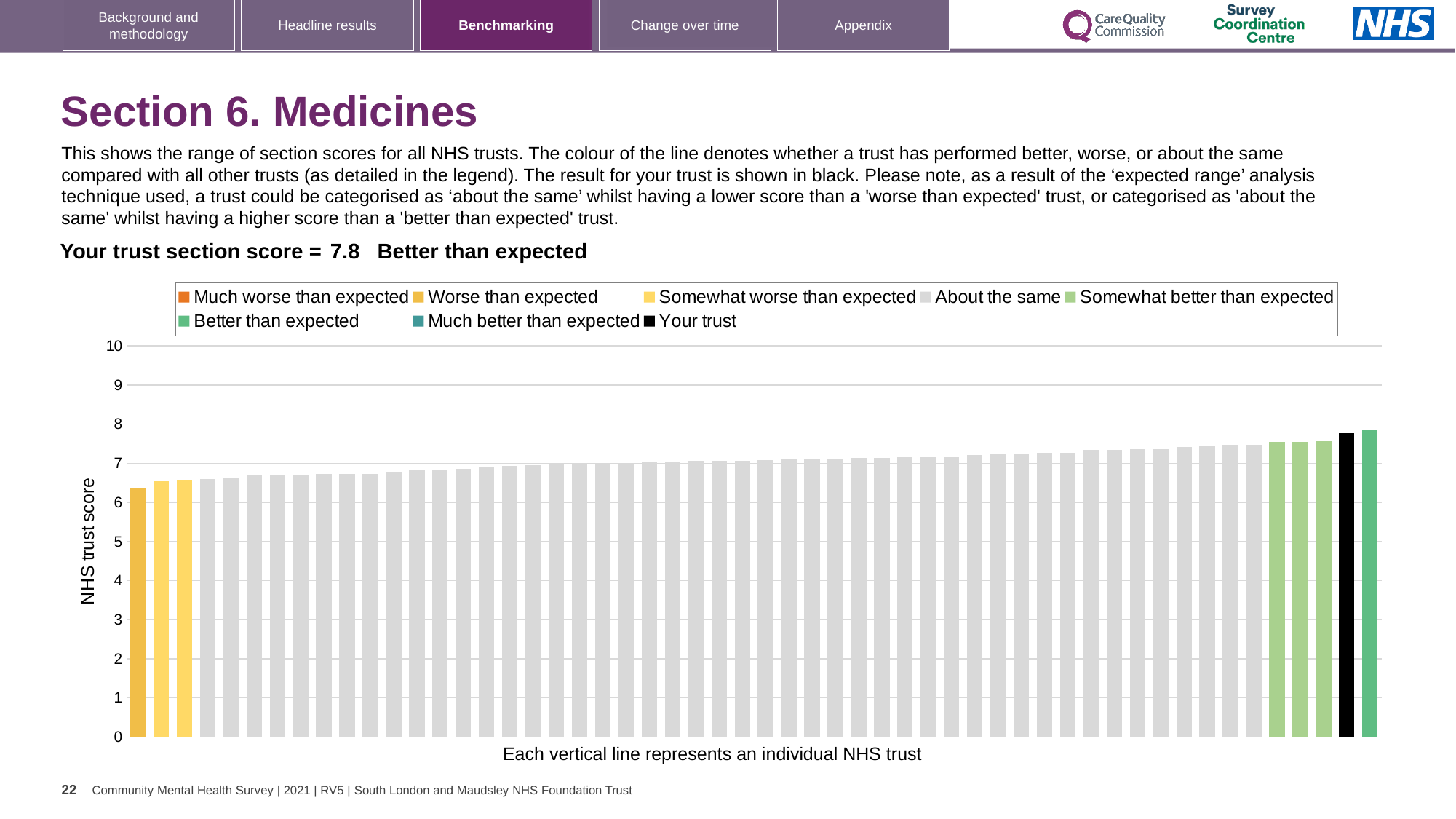
How many bars on the chart are black? 1 How is your trust's section score categorised on the slide? Better than expected Do the bar values rise or fall from left to right along the x axis? rise What is the section score for your trust shown on the slide? 7.8 What kind of chart is shown on the slide? bar chart What is the label on the vertical axis of the chart? NHS trust score Is the value of the leftmost bar greater or less than 7? less Is the value of the rightmost bar greater or less than 7? greater Which is larger: the value for your trust or the value of the leftmost bar? your trust Is the value for your trust greater or less than 7? greater How many entries does the chart legend list? 8 What colour is the bar representing your trust? black